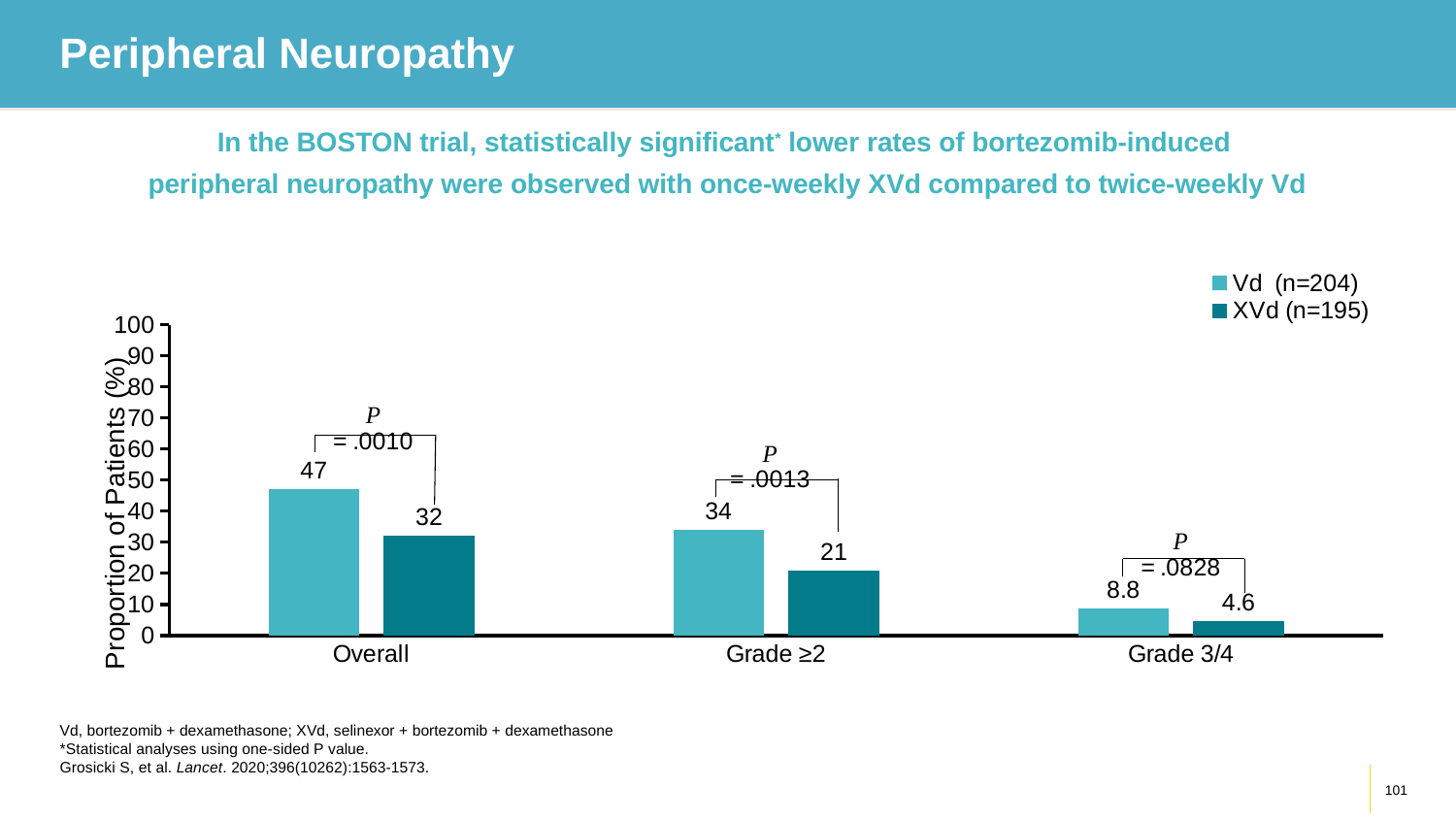
What kind of chart is shown on the slide? Bar chart What is the difference between the Vd (n=204) and XVd (n=195) values in the Grade 3/4 category? 4.2 Which category has the lowest value for XVd (n=195)? Grade 3/4 What is the value for Vd (n=204) in the Overall category? 47 What is the label of the y axis? Proportion of Patients (%) Which category has the highest value for Vd (n=204)? Overall In the Grade ≥2 category, which series has the larger value, Vd (n=204) or XVd (n=195)? Vd (n=204) What is the value for XVd (n=195) in the Grade 3/4 category? 4.6 How many categories are shown on the x axis? 3 What is the value for XVd (n=195) in the Grade ≥2 category? 21 How many series does the legend list? 2 What is the difference between the Vd (n=204) and XVd (n=195) values in the Overall category? 15